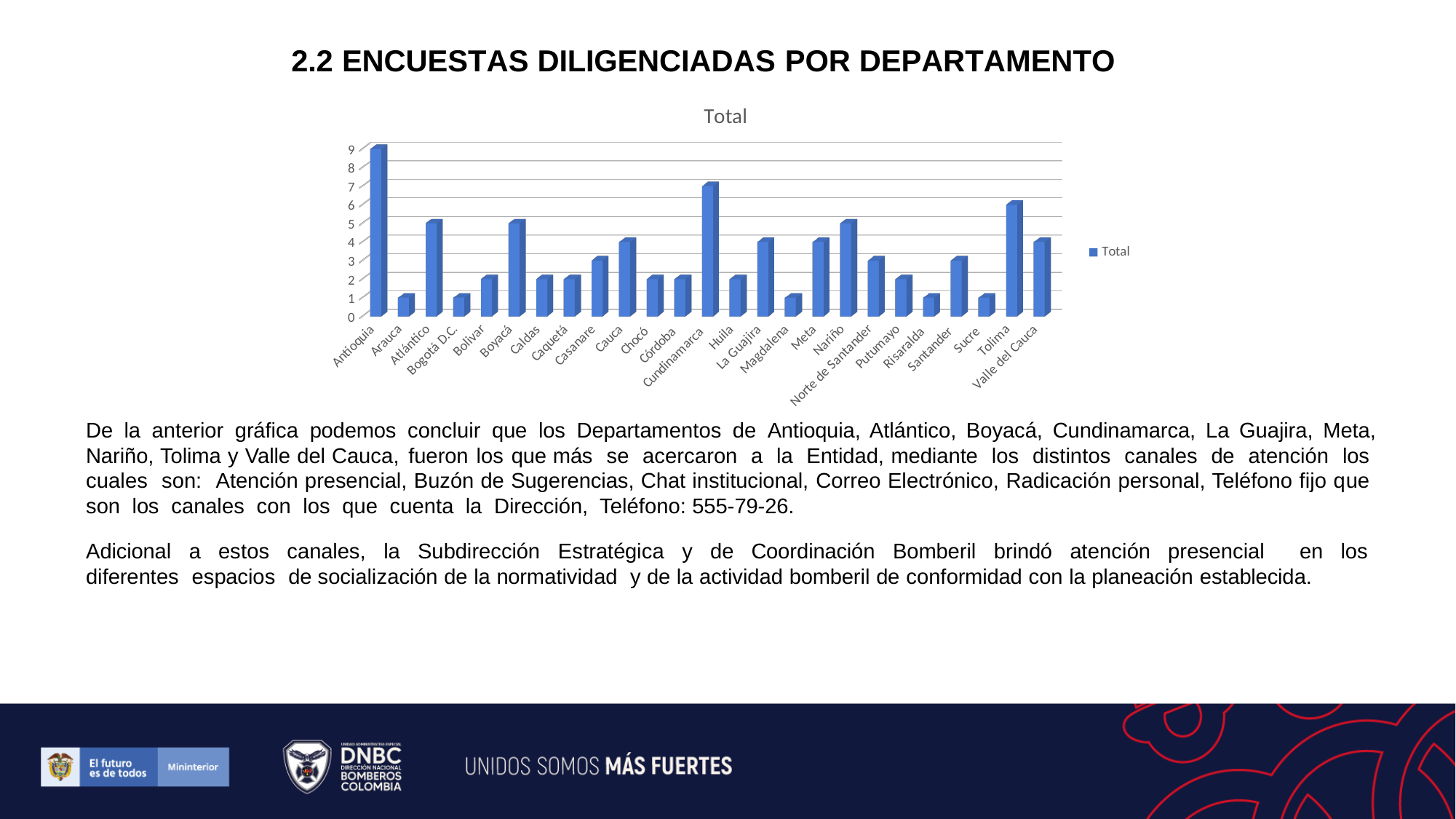
What is the value for Casanare? 3 What is the difference between the values for Antioquia and Cundinamarca? 2 What is the title of the chart? Total How many departments are shown on the x axis? 25 What is the value for Cundinamarca? 7 What kind of chart is shown on the slide? Bar chart Is the value for Tolima greater or less than 5? greater Which department has the highest value? Antioquia How many series does the legend list? 1 What is the value for Tolima? 6 Which is larger, the value for Nariño or the value for Meta? Nariño What is the value for Antioquia? 9